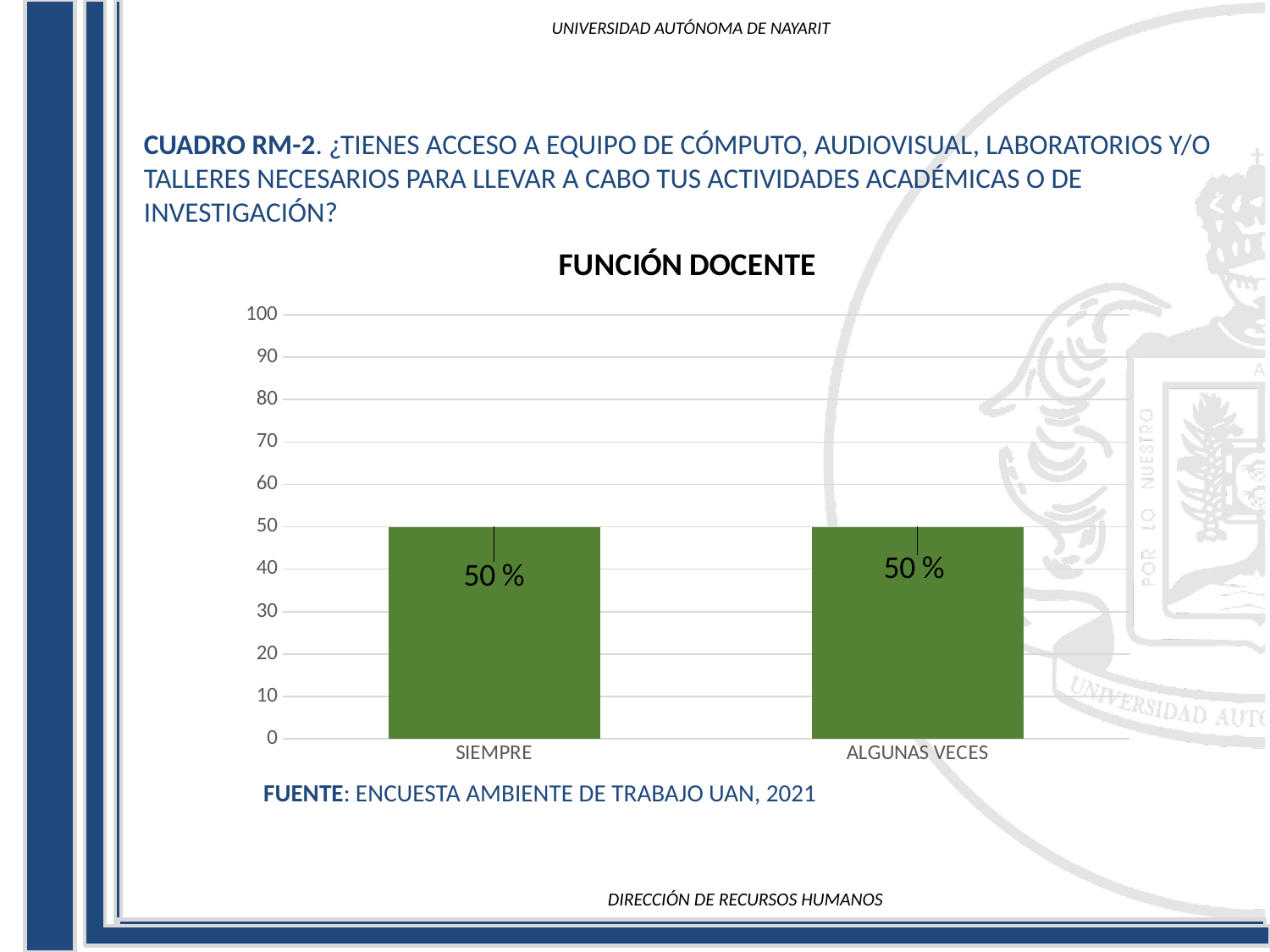
What is the value for ALGUNAS VECES? 50 % What colour are the bars in the chart? green What is the title of the chart? FUNCIÓN DOCENTE What is the highest value shown on the y axis? 100 What is the difference between the values for SIEMPRE and ALGUNAS VECES? 0 % What is the value for SIEMPRE? 50 % How many categories are shown on the x axis? 2 Is the value for ALGUNAS VECES greater or less than 40? greater Is the value for SIEMPRE greater or less than 60? less What kind of chart is shown on the slide? bar chart